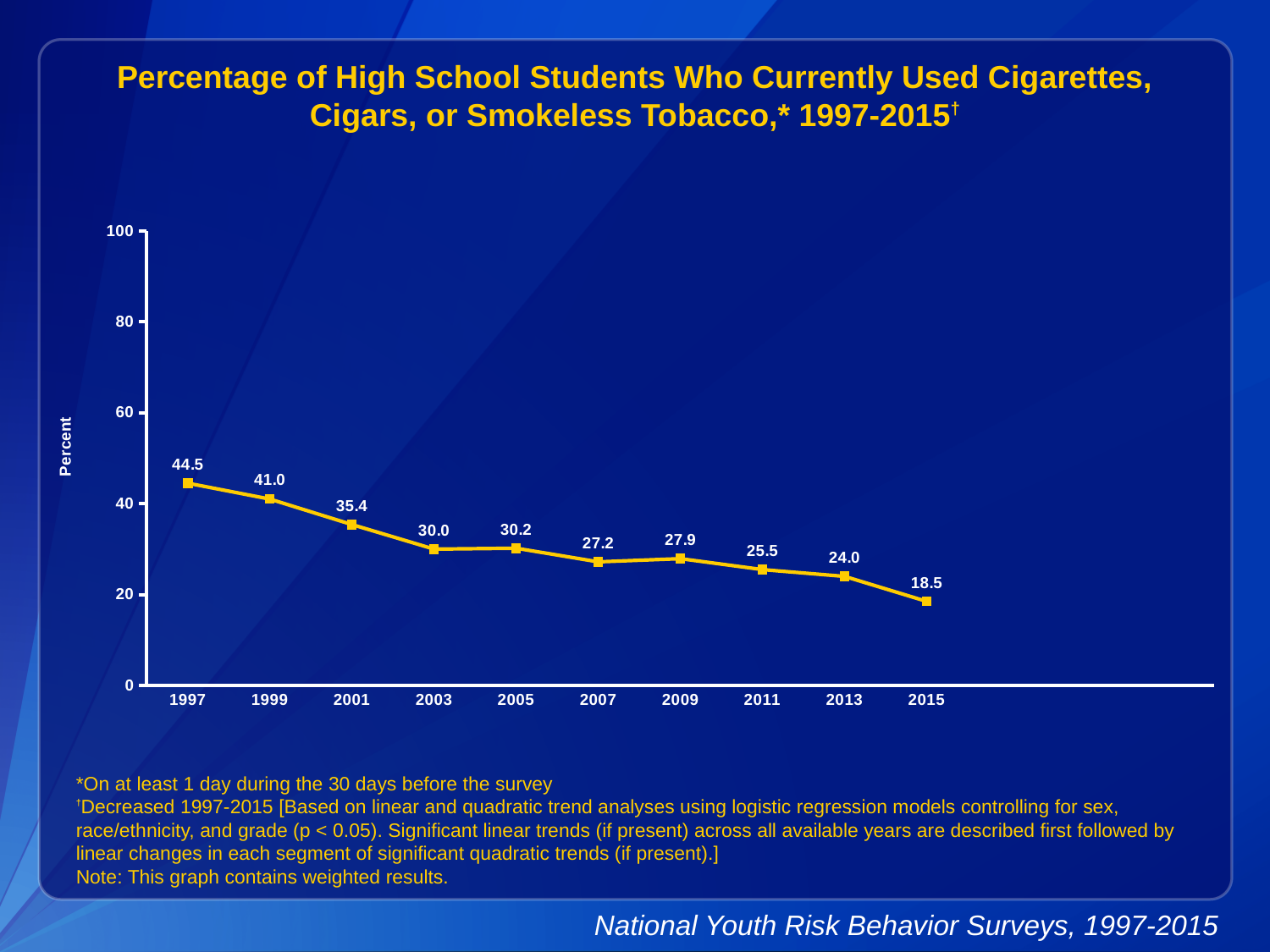
Is the value for 2001 greater or less than 40? less Which year has the lowest percentage? 2015 Which year has the highest percentage? 1997 What was the percentage of high school students who currently used cigarettes, cigars, or smokeless tobacco in 1997? 44.5 Do the values generally rise or fall from 1997 to 2015? fall What was the percentage in 2015? 18.5 How many years are plotted on the x axis? 10 What is the difference between the 1997 value and the 2015 value? 26.0 What is the label on the y axis? Percent Which year has a higher value, 2007 or 2009? 2009 What kind of chart is shown? line chart What value is shown for 2005? 30.2